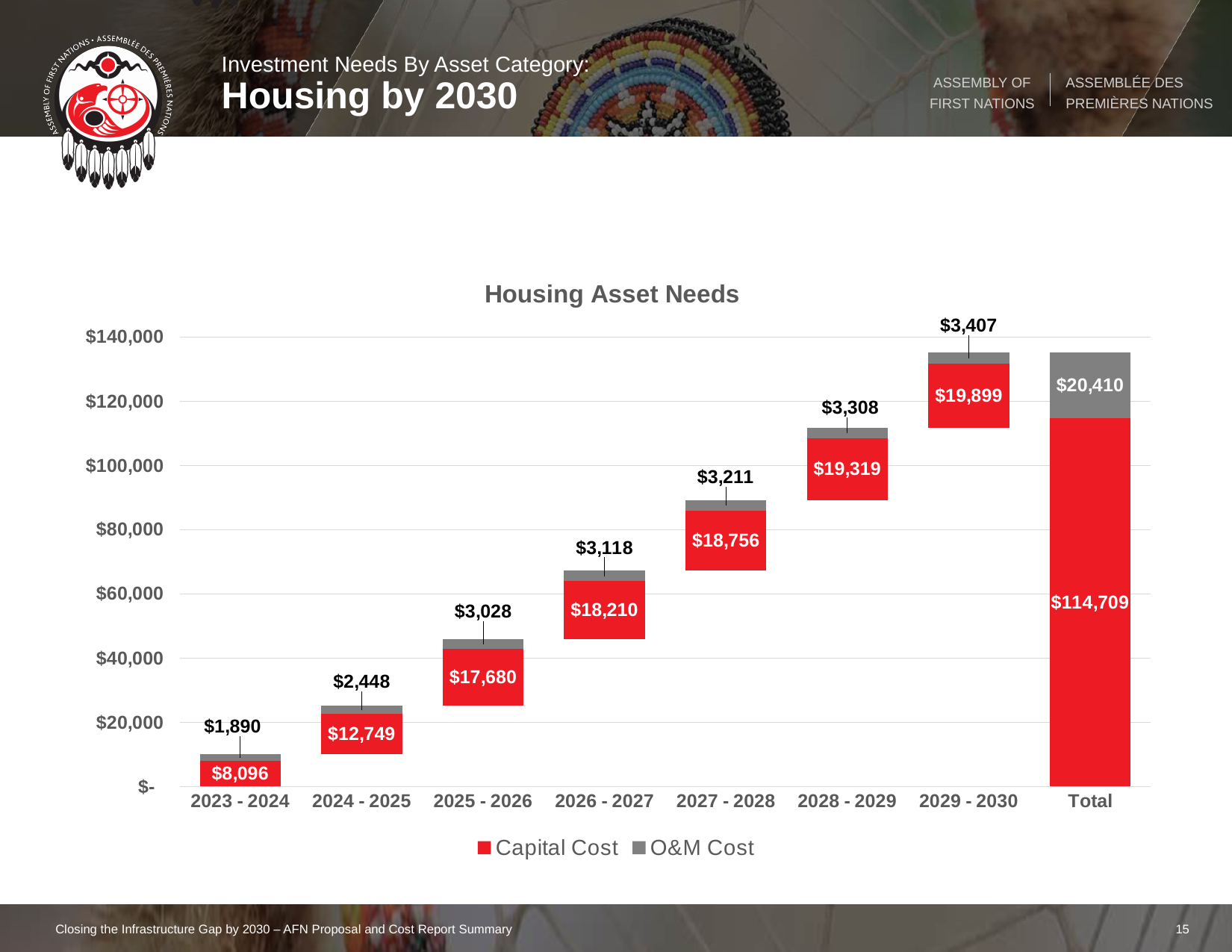
What is the combined Capital Cost and O&M Cost for 2023 - 2024? $9,986 Which is larger, the O&M Cost for 2027 - 2028 or for 2026 - 2027? 2027 - 2028 How many categories are shown on the x axis? 8 What is the difference between the Capital Cost for 2024 - 2025 and 2023 - 2024? $4,653 What is the combined Capital Cost and O&M Cost for the Total bar? $135,119 What is the O&M Cost for 2029 - 2030? $3,407 Excluding the Total bar, which year has the highest O&M Cost? 2029 - 2030 Excluding the Total bar, which year has the lowest Capital Cost? 2023 - 2024 What is the Capital Cost shown for the Total bar? $114,709 How many series does the legend list? 2 What is the Capital Cost for 2025 - 2026? $17,680 What type of chart is shown? Stacked bar chart